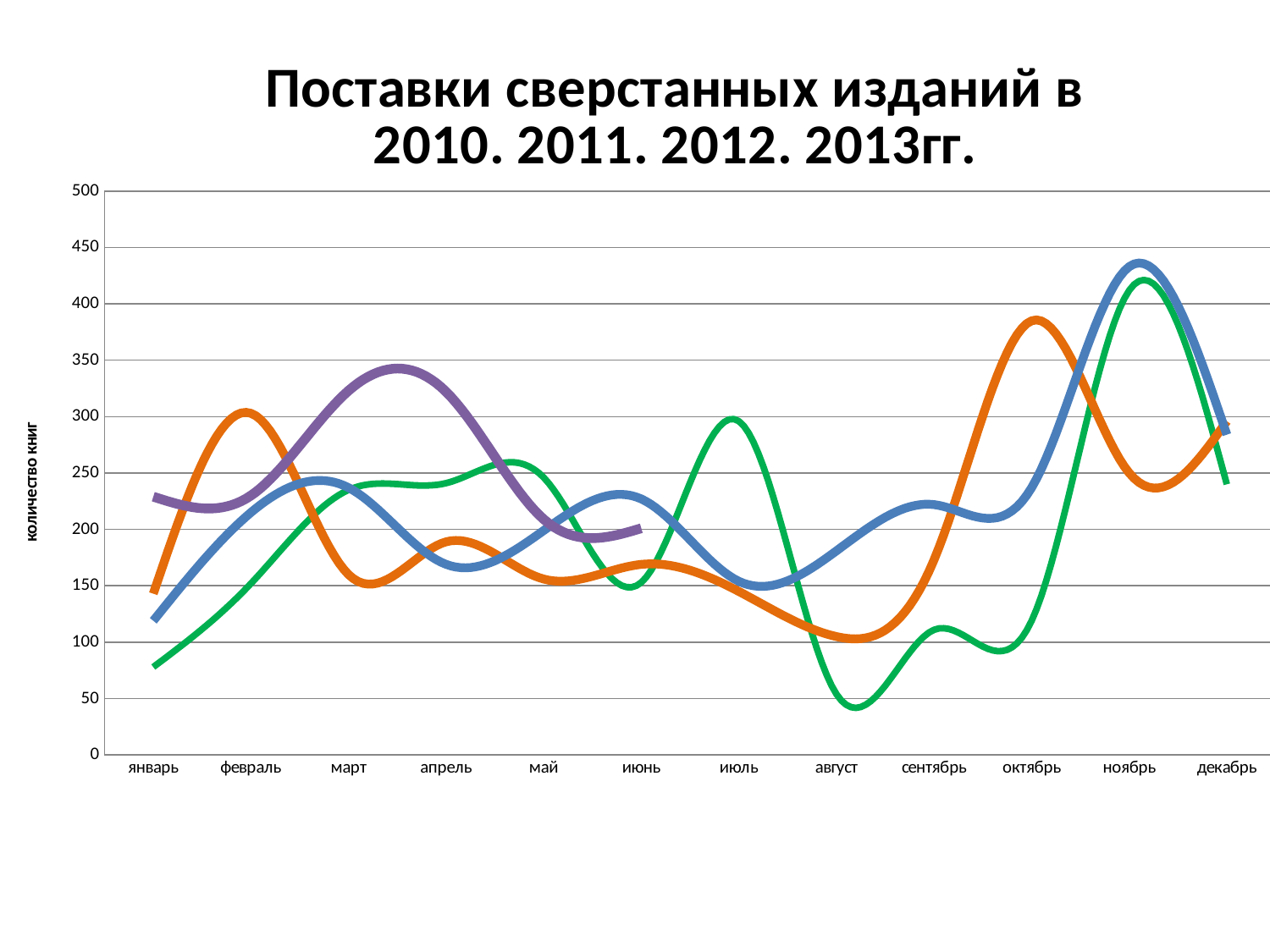
In which month does the blue line reach its highest value? ноябрь In which month does the orange line reach its highest value? октябрь What is the label on the vertical axis? количество книг Is the value of the blue line in ноябрь greater or less than 400? greater How many months are shown along the x axis? 12 In апрель, which line has the larger value, the purple line or the blue line? purple Is the value of the green line in январь greater or less than 100? less What kind of chart is shown on the slide? line chart In ноябрь, which line has the larger value, the blue line or the orange line? blue What is the title of the chart? Поставки сверстанных изданий в 2010. 2011. 2012. 2013гг. In which month does the green line reach its lowest value? август